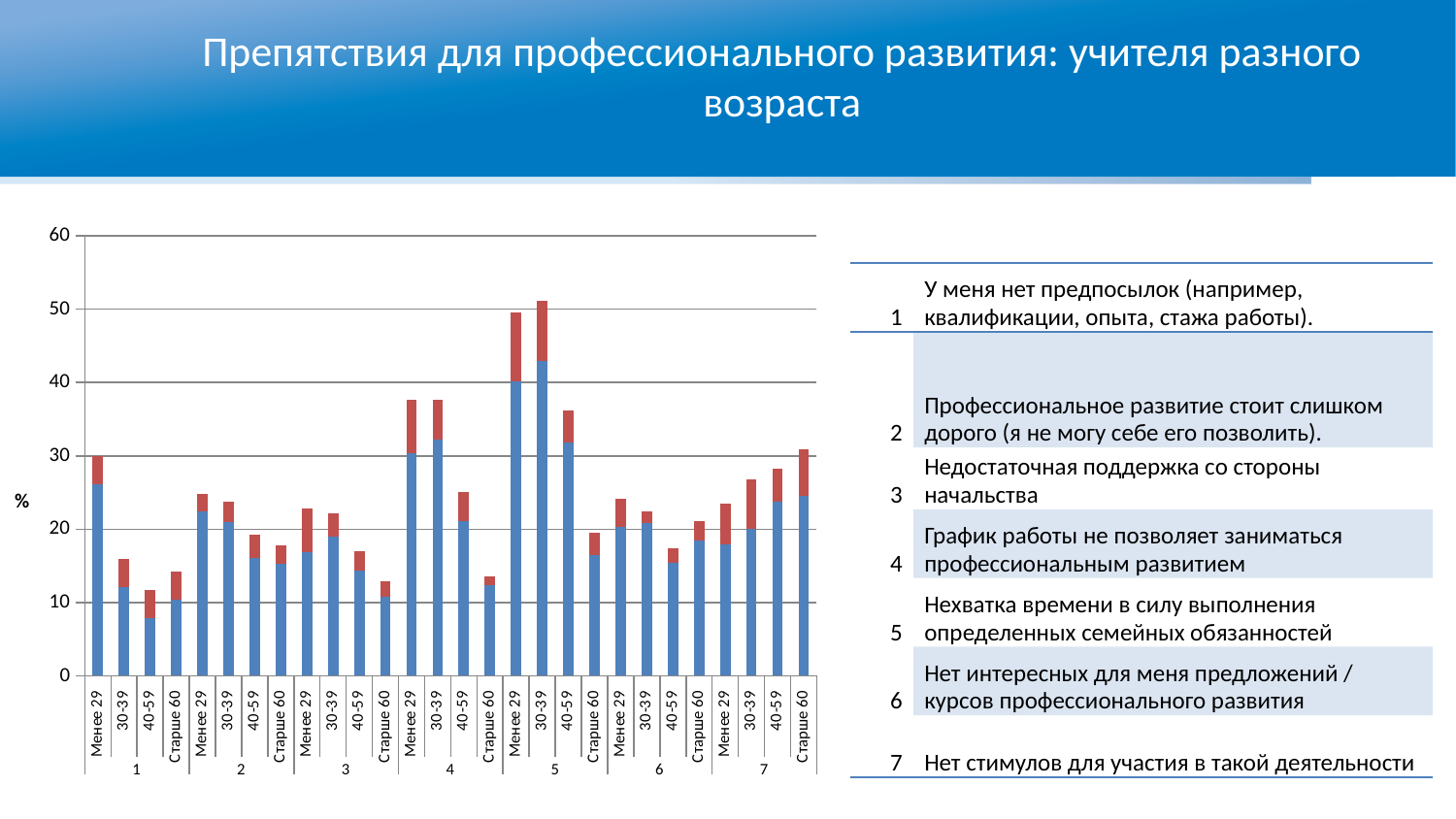
Which bar in the chart reaches the highest value? 30-39 in group 5 Is the value for 40-59 in group 6 greater or less than 20? less Within group 7, do the bars rise or fall as the age category increases from Менее 29 to Старше 60? rise Is the value for 30-39 in group 1 greater or less than 20? less How many stacked series (colours) make up each bar in the chart? 2 How many age categories are shown within each numbered group on the chart? 4 How many numbered groups of obstacles are shown along the x axis of the chart? 7 What kind of chart is shown on the slide? Stacked bar chart Is the value for Менее 29 in group 4 greater or less than 30? greater Which is larger: the bar for 30-39 in group 5 or the bar for 30-39 in group 1? 30-39 in group 5 What label is shown on the vertical axis of the chart? %